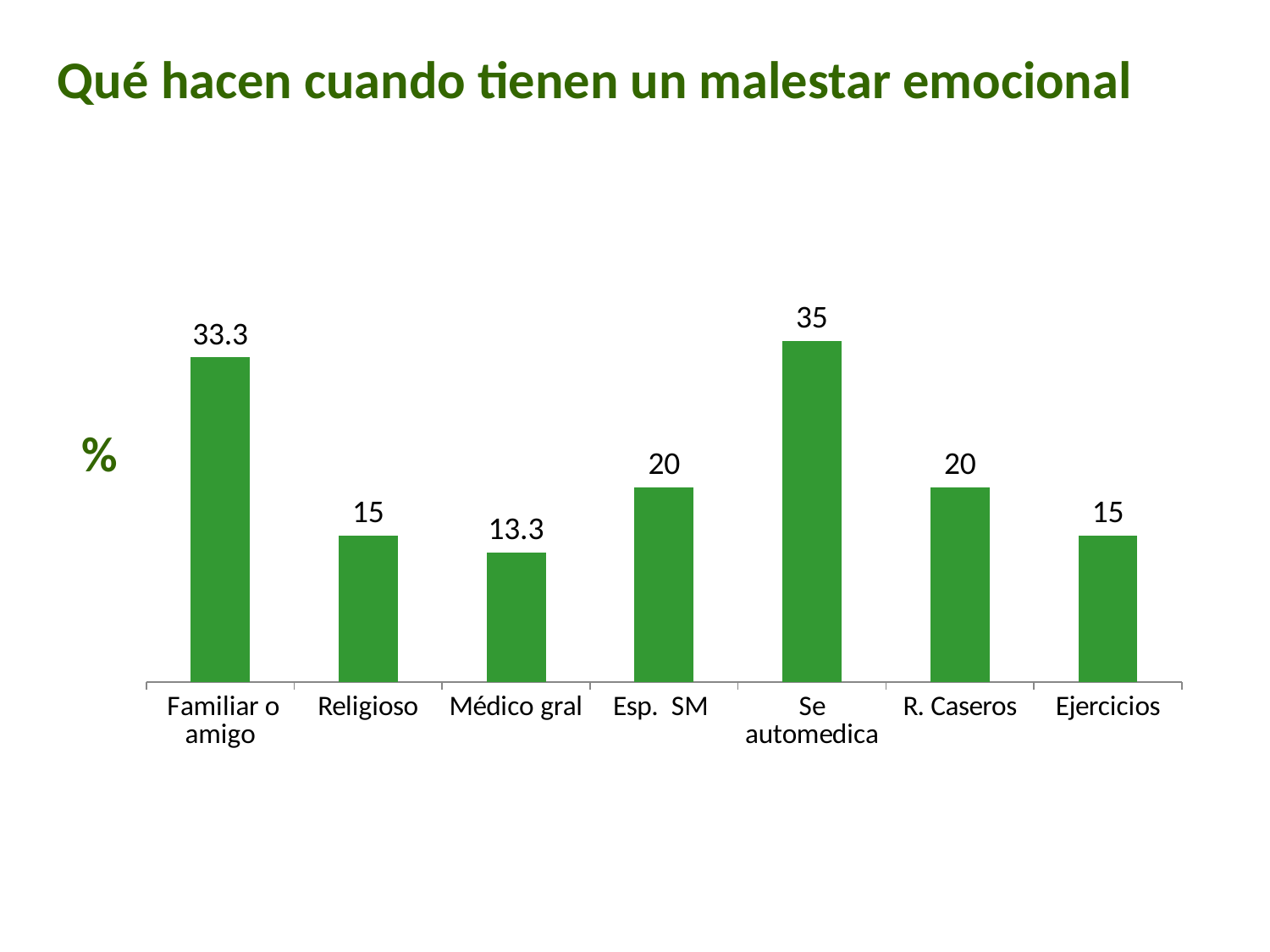
What kind of chart is shown on the slide? Bar chart What is the value for Médico gral? 13.3 Which is larger, the value for Familiar o amigo or the value for Esp. SM? Familiar o amigo Which category has the highest value? Se automedica Which category has the lowest value? Médico gral What is the difference between the values for Esp. SM and Religioso? 5 What is the value for R. Caseros? 20 What is the value for Se automedica? 35 What is the title of the chart? Qué hacen cuando tienen un malestar emocional What is the value for Familiar o amigo? 33.3 How many categories are shown in the chart? 7 What is the difference between the values for Se automedica and Familiar o amigo? 1.7